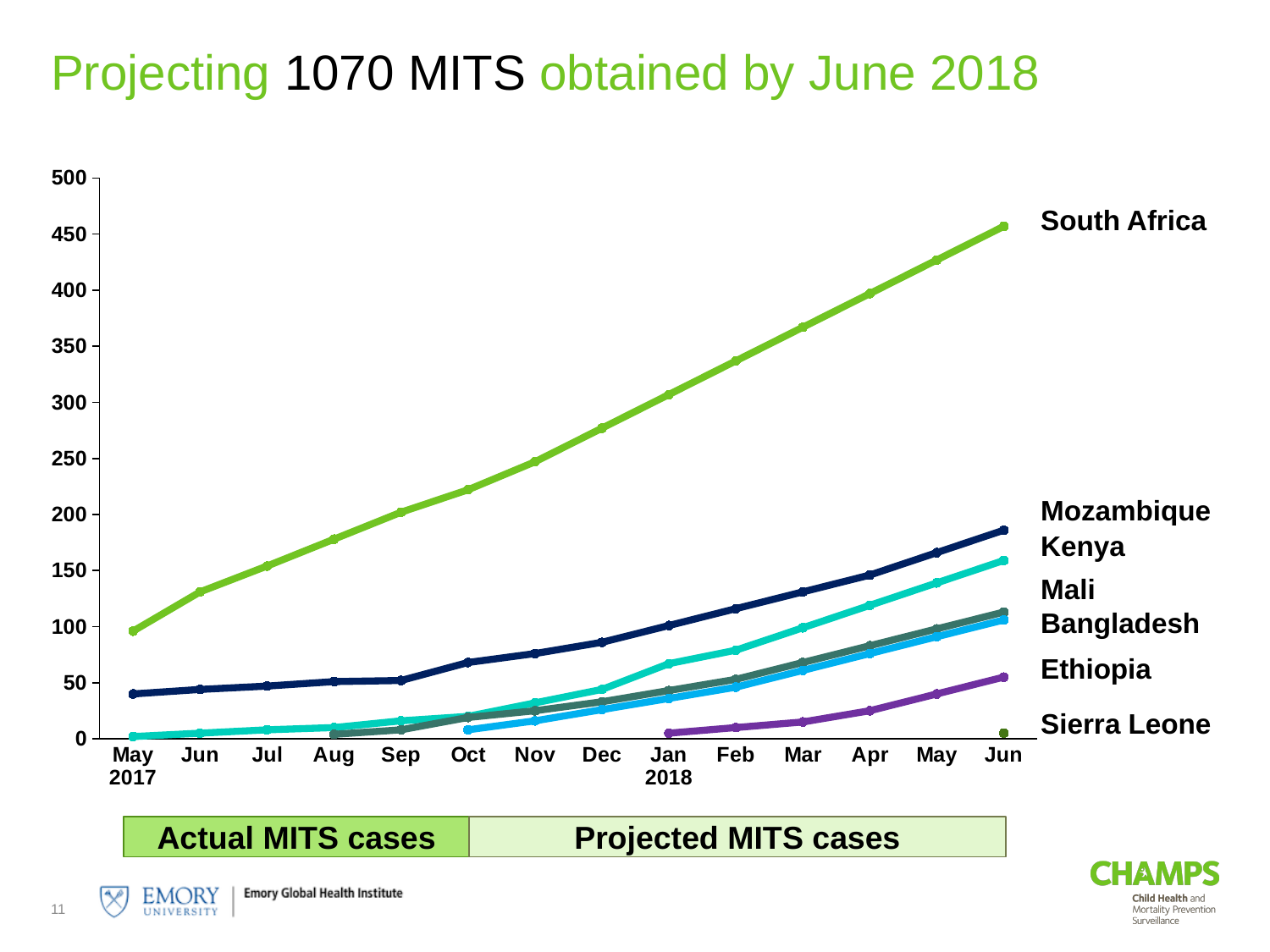
In Jun 2018, which is larger, the value for Mozambique or the value for Kenya? Mozambique Which country has the highest projected value in Jun 2018? South Africa How many months are shown along the x axis of the chart? 14 How many countries are plotted as lines on the chart? 7 Is the value for South Africa in Jun 2018 greater or less than 400? greater Which country has the lowest value in Jun 2018? Sierra Leone What is the title of the chart on the slide? Projecting 1070 MITS obtained by June 2018 What kind of chart is shown on the slide? Line chart Does the South Africa line rise or fall from May 2017 to Jun 2018? Rise Is the value for South Africa in Jan 2018 greater or less than 250? greater Is the value for Mozambique in Jun 2018 greater or less than 150? greater